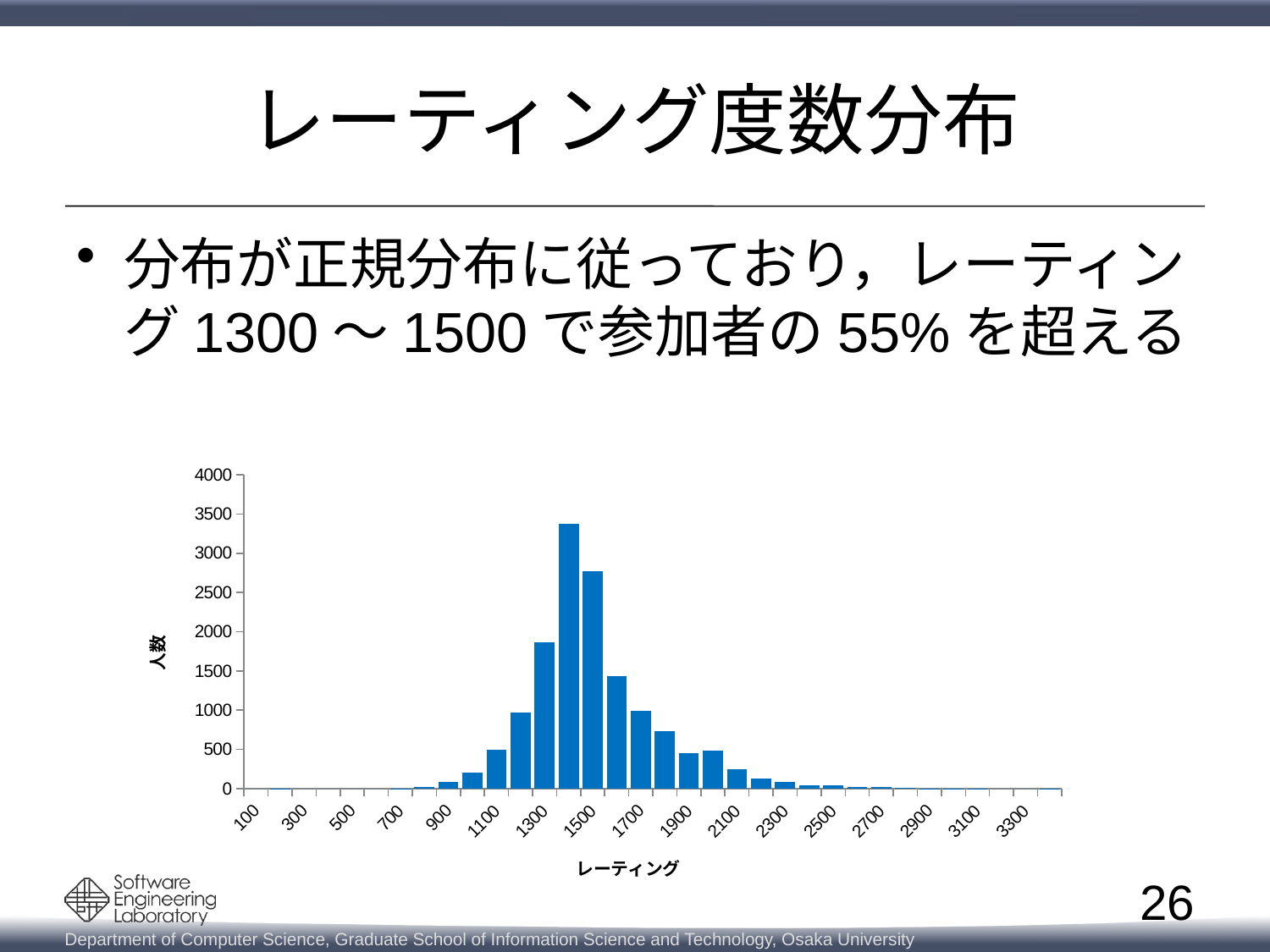
What is the title of the chart's y axis? 人数 How many rating labels are shown along the x axis? 17 What kind of chart is shown on the slide? bar chart Is the value for rating 1700 greater or less than 500? greater Is the value for rating 2100 greater or less than 500? less Is the value for rating 1100 greater or less than 1000? less What is the title of the chart's x axis? レーティング Which labeled rating has the taller bar, 1300 or 1700? 1300 Which labeled rating has the taller bar, 1300 or 1500? 1500